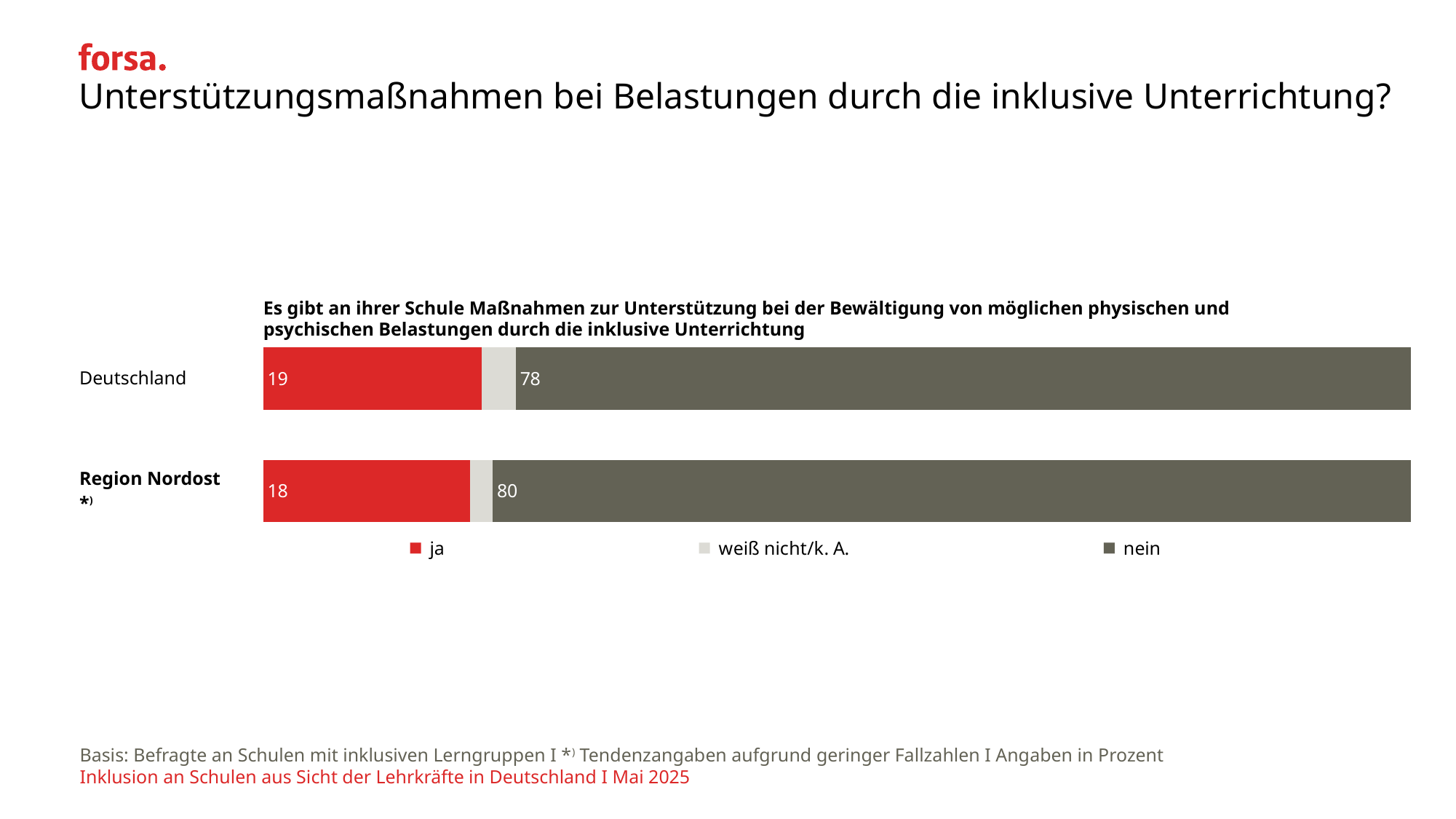
Which category has the higher value for "ja", Deutschland or Region Nordost? Deutschland What is the value for "nein" for Region Nordost? 80 What kind of chart is shown on the slide? Stacked bar chart What is the difference between the "nein" values for Region Nordost and Deutschland? 2 What is the value for "ja" for Deutschland? 19 How many series does the legend list? 3 What is the difference between the "ja" values for Deutschland and Region Nordost? 1 Which legend entry is shown in red? ja How many categories (bars) are shown in the chart? 2 What is the value for "nein" for Deutschland? 78 What is the value for "ja" for Region Nordost? 18 Which category has the higher value for "nein", Deutschland or Region Nordost? Region Nordost